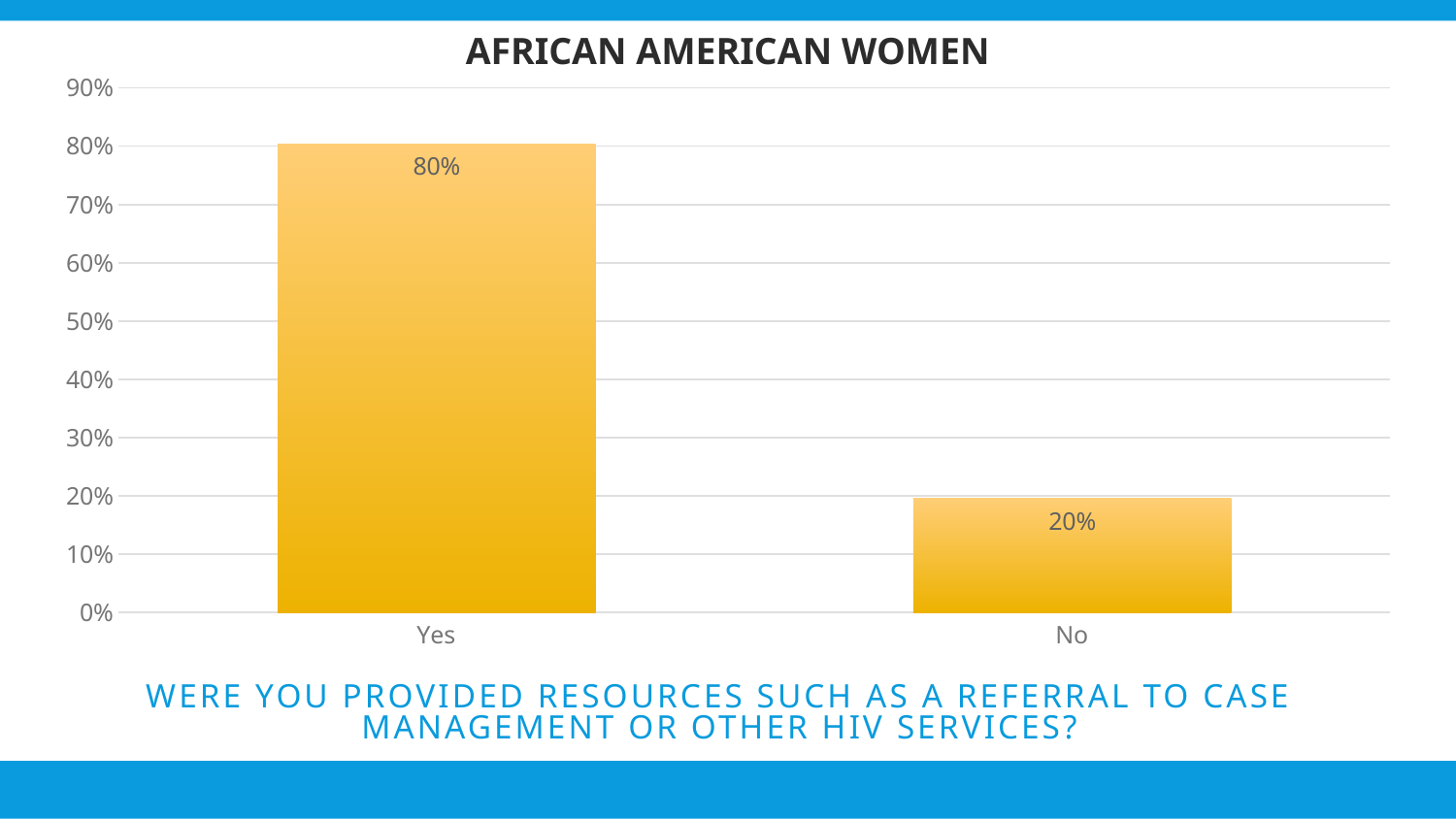
Is the value for "No" greater or less than 30%? less How many categories are shown on the x axis? 2 What is the title of the chart? AFRICAN AMERICAN WOMEN What is the difference between the values for "Yes" and "No"? 60% Which is larger, the value for "Yes" or the value for "No"? Yes What is the value for "No"? 20% Which category has the lowest value? No What is the value for "Yes"? 80% What is the highest value shown on the y axis? 90% Which category has the highest value? Yes What kind of chart is shown on the slide? Bar chart Is the value for "Yes" greater or less than 50%? greater